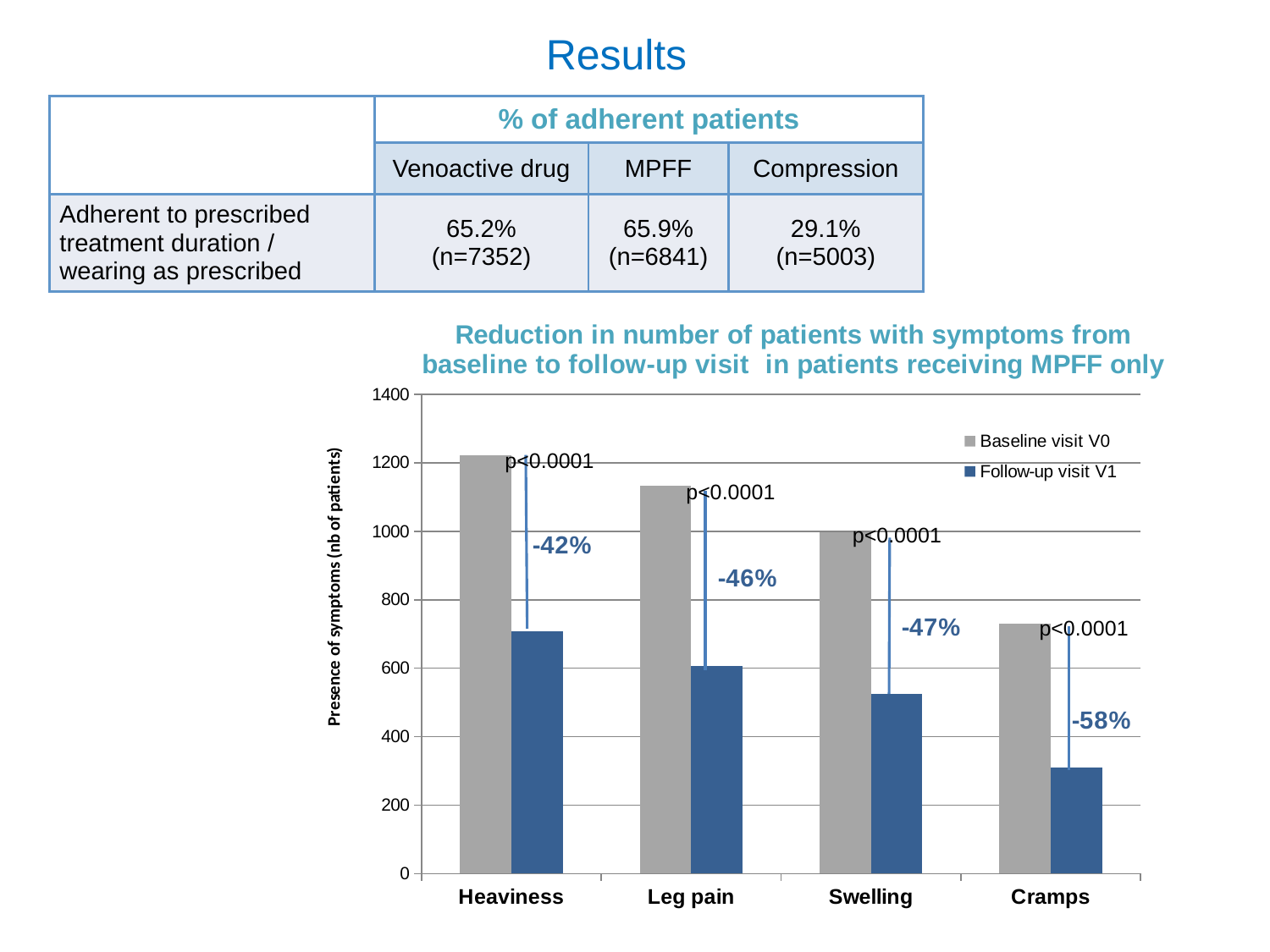
How many symptom categories are shown on the x axis of the chart? 4 What percentage reduction is labelled for Swelling? -47% Which is larger: the Baseline visit V0 value for Leg pain or the Baseline visit V0 value for Swelling? Leg pain Which symptom has the lowest Follow-up visit V1 value? Cramps Which symptom has the highest Baseline visit V0 value? Heaviness What type of chart is shown on the slide? bar chart How many series does the chart legend list? 2 Is the Follow-up visit V1 value for Heaviness greater or less than 600? greater What percentage reduction is labelled for Heaviness? -42% Is the Baseline visit V0 value for Cramps greater or less than 800? less Do the Baseline visit V0 values rise or fall from Heaviness to Cramps along the x axis? fall What percentage reduction is labelled for Cramps? -58%